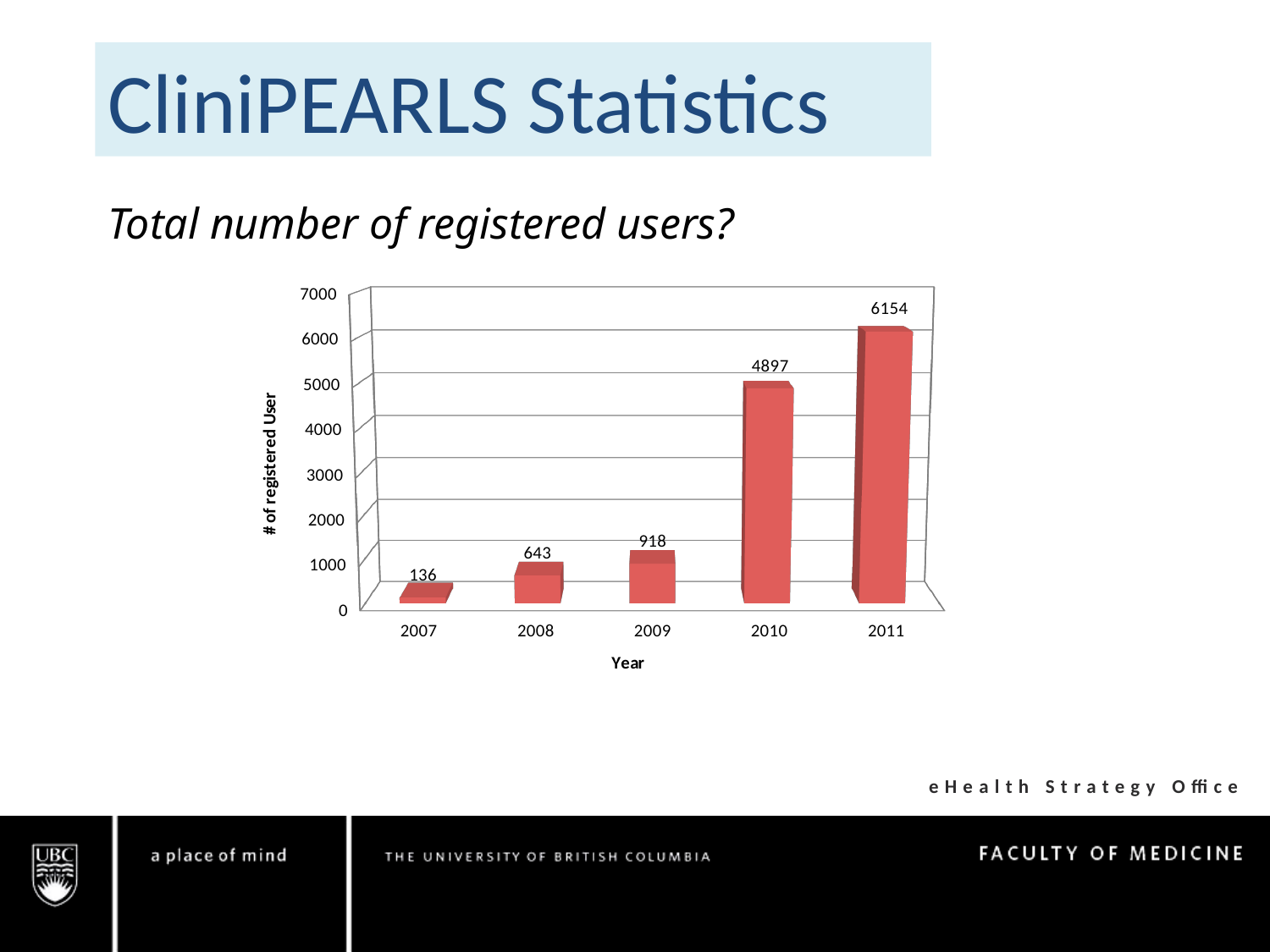
What is the number of registered users in 2009? 918 How many years are shown on the x axis? 5 Do the values rise or fall from 2007 to 2011? rise What is the number of registered users in 2010? 4897 Which year has more registered users, 2008 or 2009? 2009 What kind of chart is shown on the slide? bar chart What is the difference in registered users between 2011 and 2010? 1257 What is the difference in registered users between 2009 and 2008? 275 Is the value for 2010 greater or less than 4000? greater Which year has the lowest number of registered users? 2007 Which year has the highest number of registered users? 2011 What is the number of registered users in 2007? 136